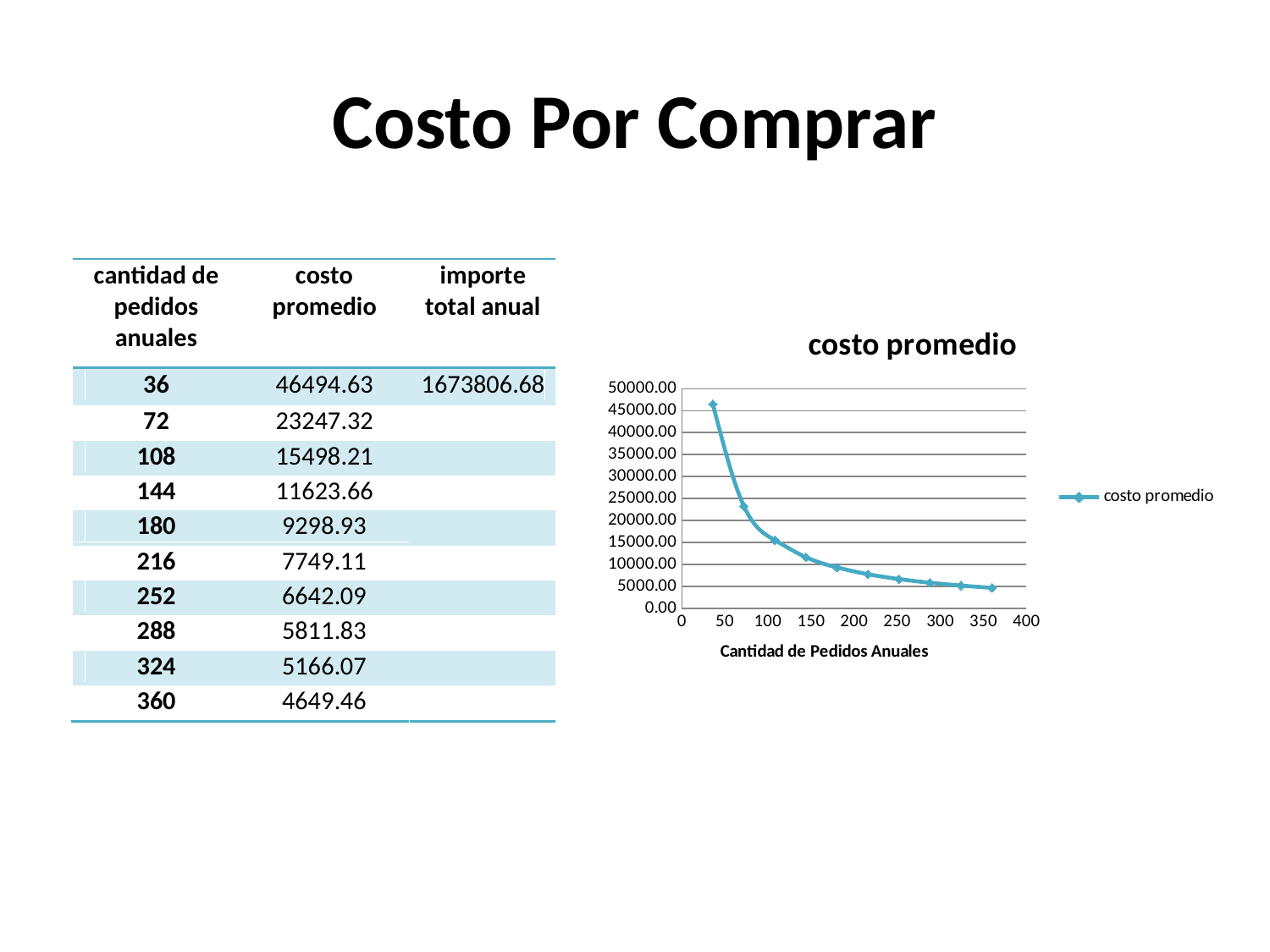
Is the costo promedio at 360 pedidos anuales greater or less than 10000.00? less Is the costo promedio at 36 pedidos anuales greater or less than 40000.00? greater At which cantidad de pedidos anuales is costo promedio highest on the chart? 36 Is the costo promedio at 72 pedidos anuales greater or less than 25000.00? less How many data points are plotted on the chart? 10 What kind of chart is shown on the slide? line chart How many series does the chart legend list? 1 Which has a larger costo promedio on the chart, 72 pedidos anuales or 144 pedidos anuales? 72 Do the values of costo promedio rise or fall as the cantidad de pedidos anuales increases? fall What is the x-axis title of the chart? Cantidad de Pedidos Anuales At which cantidad de pedidos anuales is costo promedio lowest on the chart? 360 What is the title of the chart? costo promedio